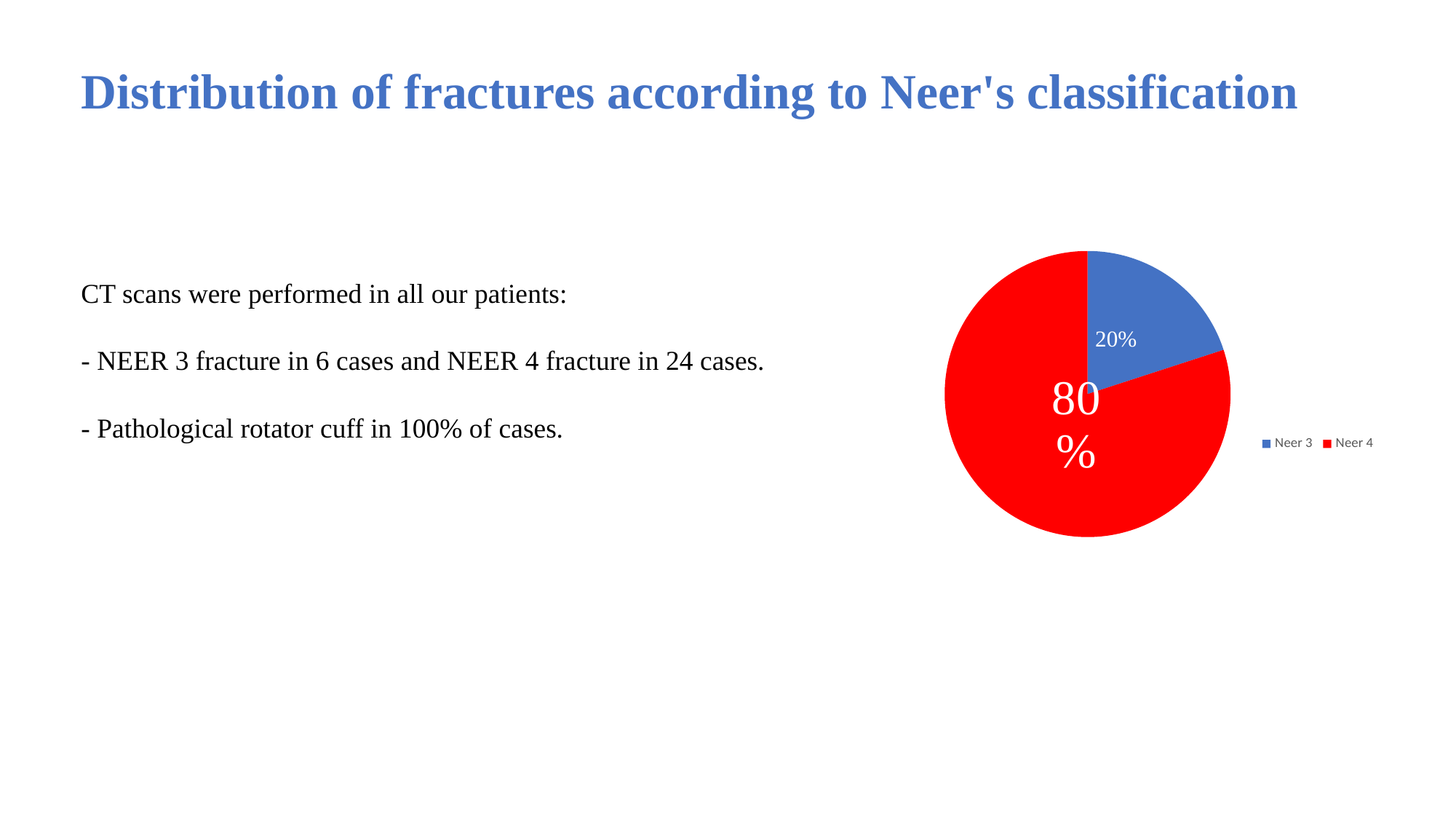
What share of the pie does Neer 4 represent? 80% How many categories does the pie chart show? 2 How many entries does the legend list? 2 What is the difference in percentage points between the Neer 4 and Neer 3 slices? 60 What kind of chart is shown on the slide? pie chart What share of the pie does Neer 3 represent? 20% Which category has the largest slice of the pie? Neer 4 Which slice is larger, Neer 3 or Neer 4? Neer 4 What colour is the Neer 4 slice? red What colour is the Neer 3 slice? blue Which category has the smallest slice of the pie? Neer 3